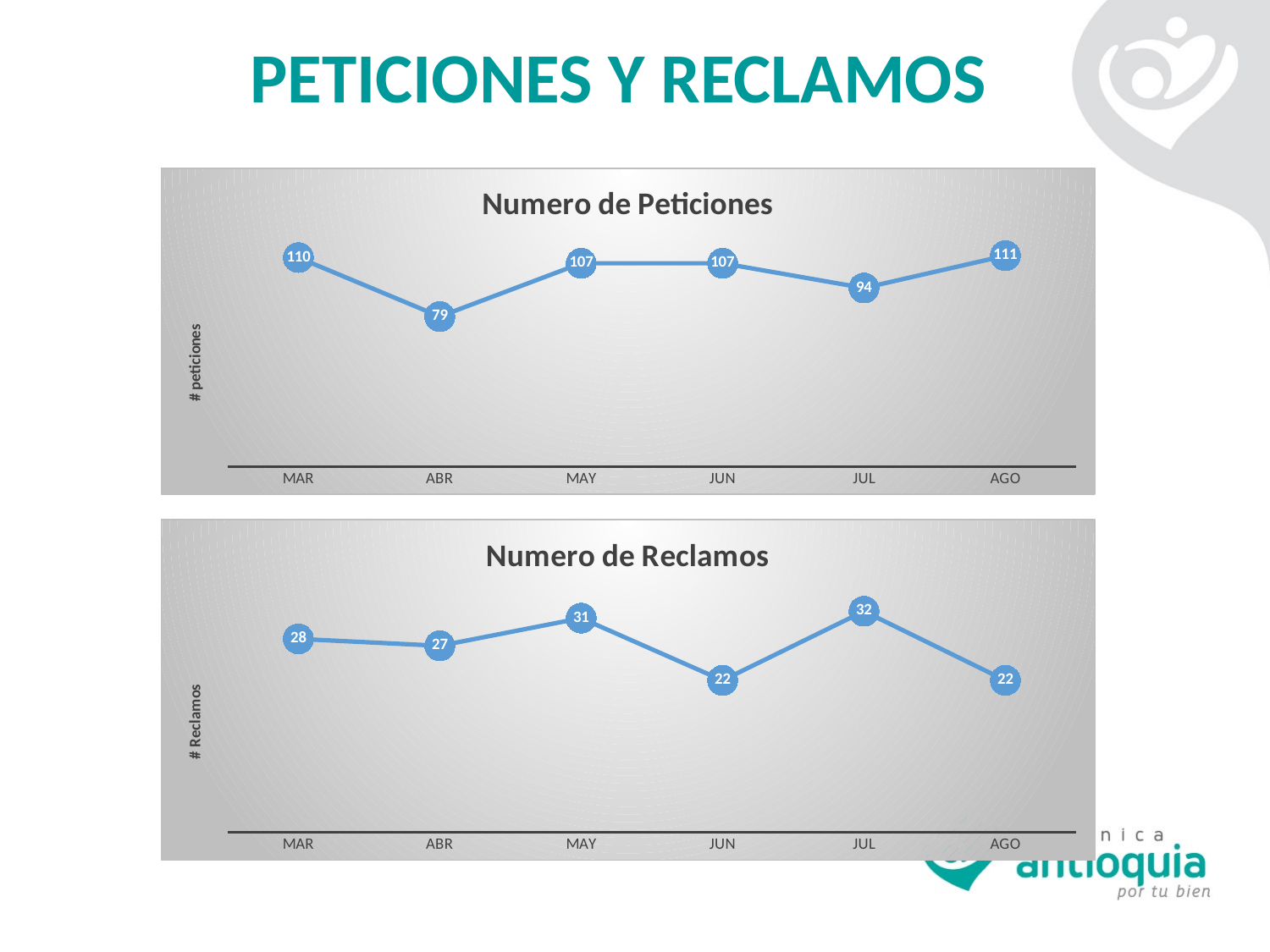
In the 'Numero de Peticiones' chart, what is the value for ABR? 79 In the 'Numero de Peticiones' chart, which month has the lowest value? ABR In the 'Numero de Reclamos' chart, what is the difference between the values for JUL and AGO? 10 In the 'Numero de Peticiones' chart, does the value rise or fall from JUL to AGO? Rise In the 'Numero de Reclamos' chart, which month has the highest value? JUL In the 'Numero de Reclamos' chart, what is the value for JUL? 32 What kind of chart is 'Numero de Peticiones'? Line chart In the 'Numero de Reclamos' chart, what is the y-axis label? # Reclamos In the 'Numero de Peticiones' chart, how many months are plotted? 6 In the 'Numero de Peticiones' chart, what is the difference between the values for MAR and JUL? 16 In the 'Numero de Reclamos' chart, which is larger, the value for MAY or the value for JUN? MAY In the 'Numero de Peticiones' chart, which month has the highest value? AGO